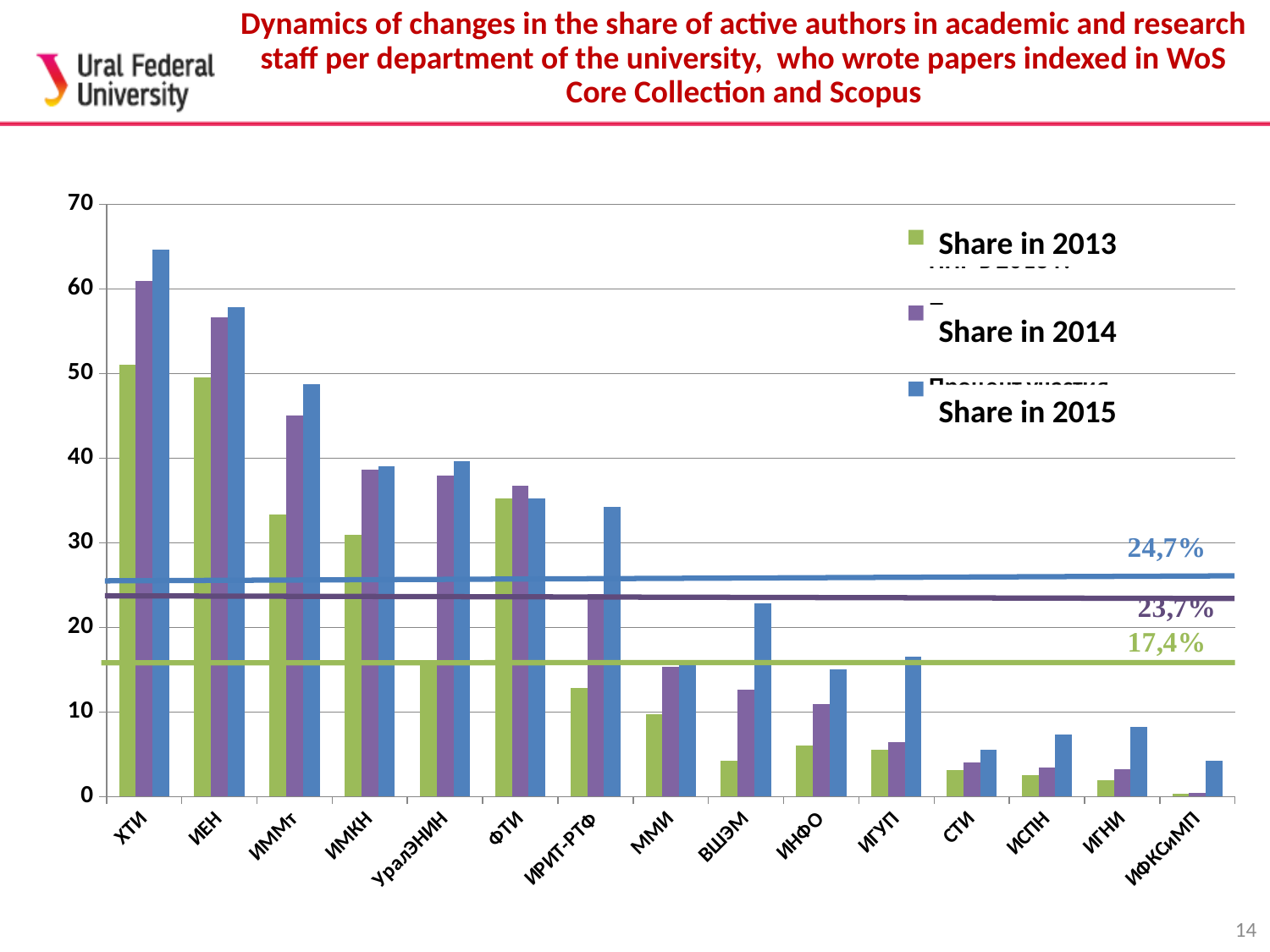
Which is larger for ИЕН: the Share in 2013 or the Share in 2015? Share in 2015 Which department has the highest Share in 2015? ХТИ Do the Share in 2015 values generally rise or fall moving from left to right along the x axis? fall What value is printed on the green horizontal line across the chart? 17,4% What value is printed on the blue horizontal line across the chart? 24,7% Is the Share in 2015 for ХТИ greater or less than 60? greater Is the Share in 2015 for ВШЭМ greater or less than 20? greater How many departments (categories) are shown along the x axis? 15 Is the Share in 2013 for ИММт greater or less than 40? less What kind of chart is shown on the slide? bar chart How many series does the legend list? 3 Which department has the lowest Share in 2013? ИФКСиМП